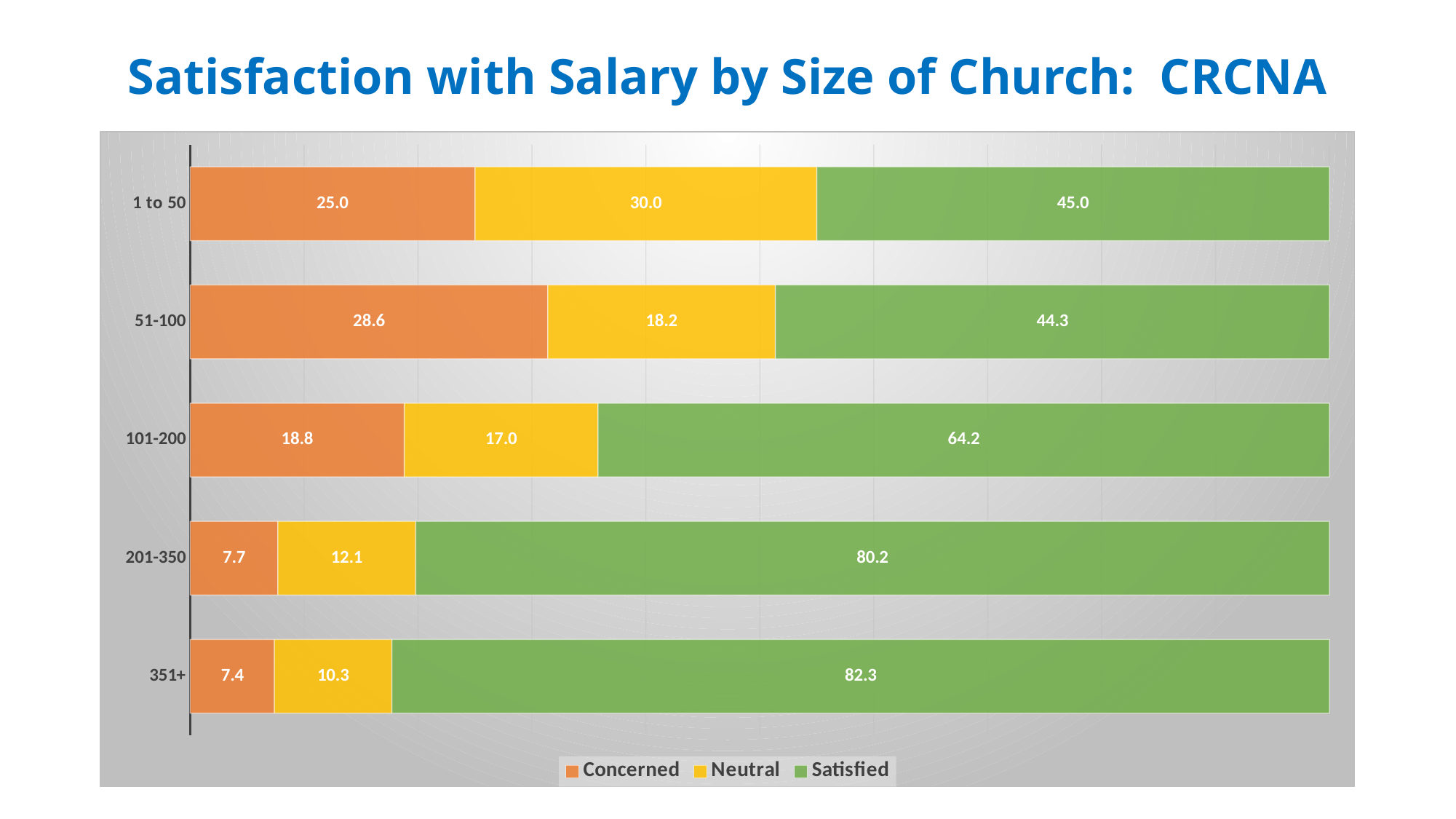
What is the total of the stacked bar for churches of size 351+? 100.0 What is the Neutral value for churches of size 1 to 50? 30.0 Which church size category has the highest Satisfied value? 351+ What kind of chart is shown on the slide? Stacked bar chart Which is larger, the Neutral value for 51-100 or the Neutral value for 101-200? 51-100 What is the Concerned value for churches of size 51-100? 28.6 How many series does the legend list? 3 Which church size category has the lowest Concerned value? 351+ What is the Satisfied value for churches of size 101-200? 64.2 How many church size categories are shown on the chart? 5 What is the title of the chart? Satisfaction with Salary by Size of Church: CRCNA What is the difference between the Satisfied values for 201-350 and 101-200? 16.0